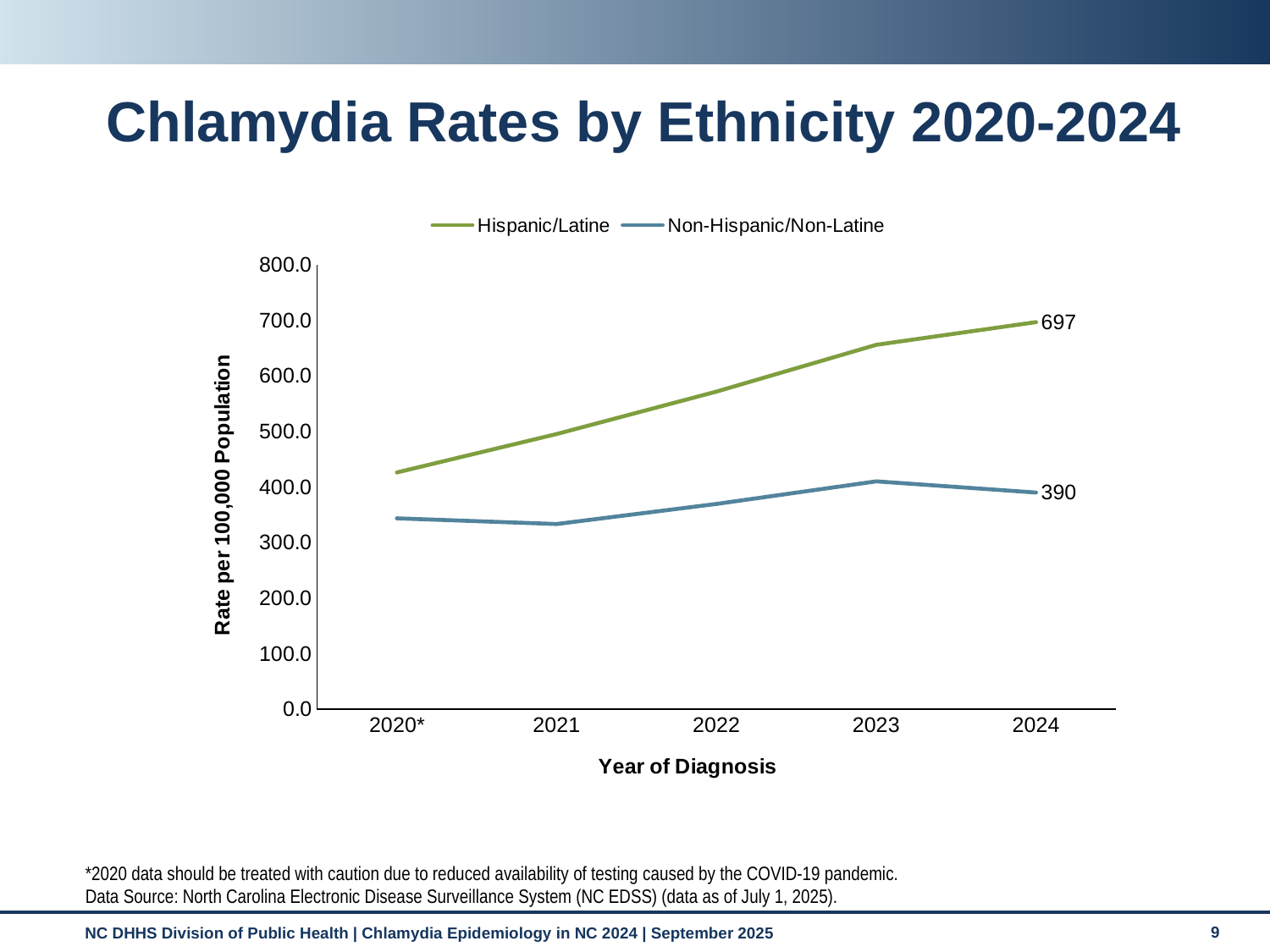
What is the difference between the Hispanic/Latine and Non-Hispanic/Non-Latine rates in 2024? 307 What kind of chart is shown on the slide? Line chart Does the Hispanic/Latine rate rise or fall from 2020* to 2024? Rise How many series does the legend list? 2 How many years are shown on the x axis? 5 What is the Non-Hispanic/Non-Latine chlamydia rate in 2024? 390 Which series has the higher rate in 2024, Hispanic/Latine or Non-Hispanic/Non-Latine? Hispanic/Latine In which year is the Hispanic/Latine rate highest? 2024 Is the Hispanic/Latine rate in 2020* greater or less than 400? greater Is the Non-Hispanic/Non-Latine rate in 2022 greater or less than 400? less In which year is the Non-Hispanic/Non-Latine rate lowest? 2021 What is the Hispanic/Latine chlamydia rate in 2024? 697